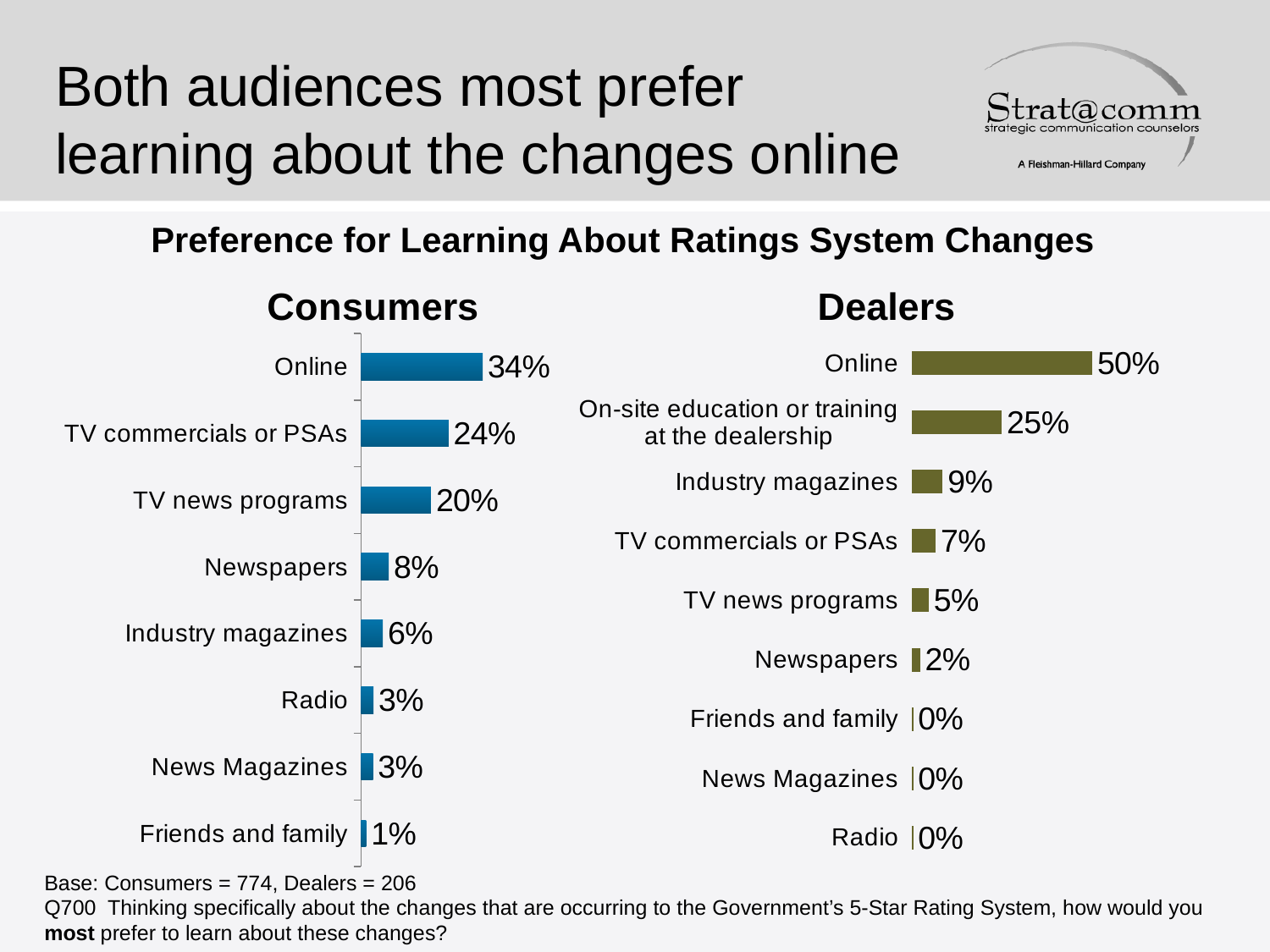
In the Dealers chart, which category has the highest value? Online In the Dealers chart, what is the value for Industry magazines? 9% In the Dealers chart, what is the value for On-site education or training at the dealership? 25% How many categories are shown in the Consumers chart? 8 How many categories are shown in the Dealers chart? 9 Which is larger: the Consumers value for Newspapers or the Dealers value for Newspapers? Consumers In the Consumers chart, what is the value for TV news programs? 20% What type of chart is the Dealers chart? Bar chart In the Consumers chart, what is the difference between Online and TV commercials or PSAs? 10% In the Consumers chart, what is the value for Online? 34% In the Dealers chart, what is the difference between Online and On-site education or training at the dealership? 25% In the Consumers chart, which category has the lowest value? Friends and family